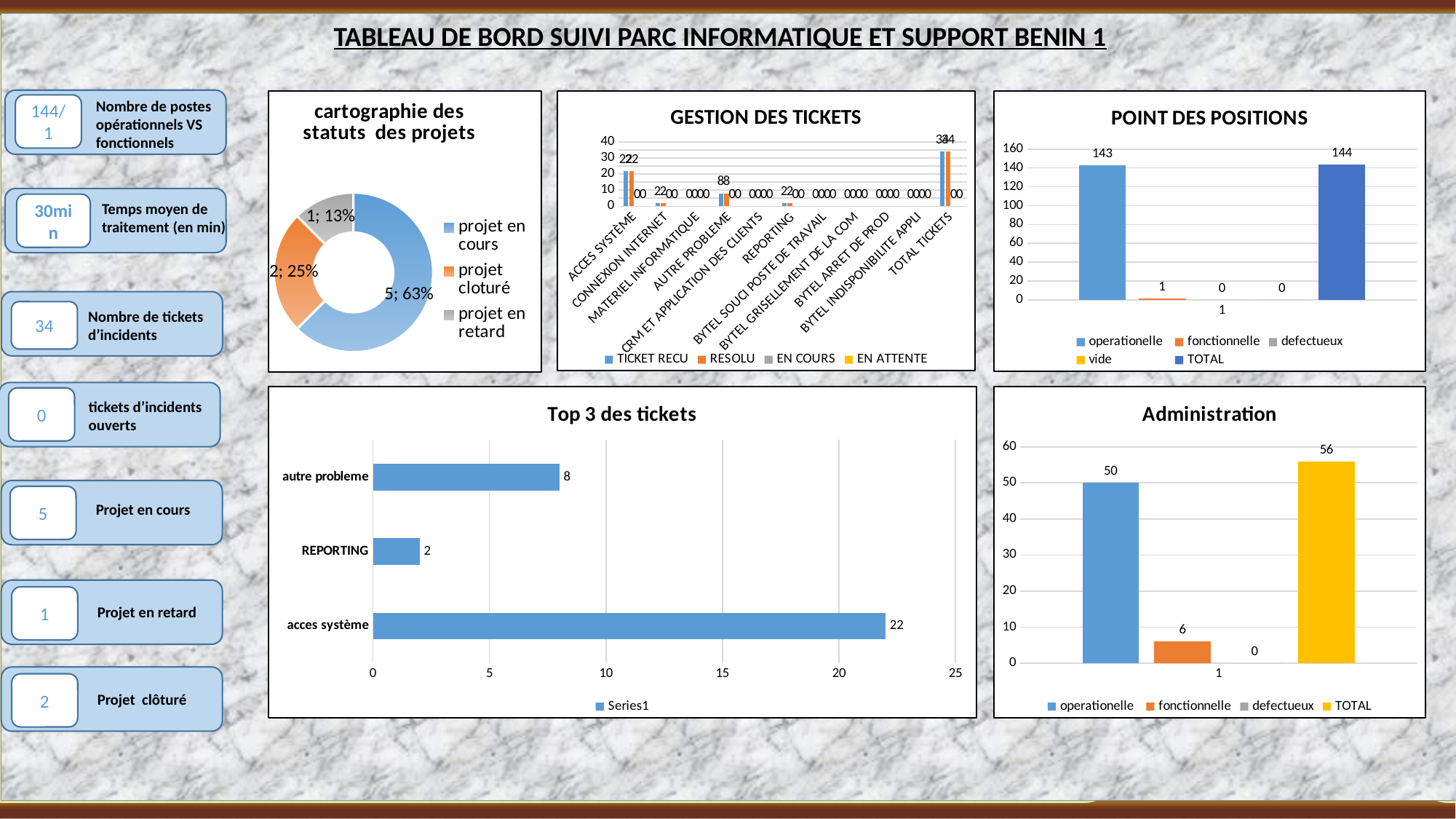
How many series does the legend of the 'GESTION DES TICKETS' chart list? 4 What kind of chart is 'Top 3 des tickets'? bar chart In the 'cartographie des statuts des projets' chart, what share of the doughnut is 'projet en cours'? 63% In the 'Top 3 des tickets' chart, what is the value for autre probleme? 8 How many series does the legend of the 'POINT DES POSITIONS' chart list? 5 In the 'POINT DES POSITIONS' chart, which series has the highest value? TOTAL In the 'Administration' chart, what is the difference between TOTAL and operationelle? 6 In the 'Top 3 des tickets' chart, what is the value for acces système? 22 How many slices does the 'cartographie des statuts des projets' doughnut chart have? 3 In the 'POINT DES POSITIONS' chart, what is the value for operationelle? 143 In the 'Top 3 des tickets' chart, what is the difference between acces système and REPORTING? 20 In the 'Administration' chart, what is the value for fonctionnelle? 6